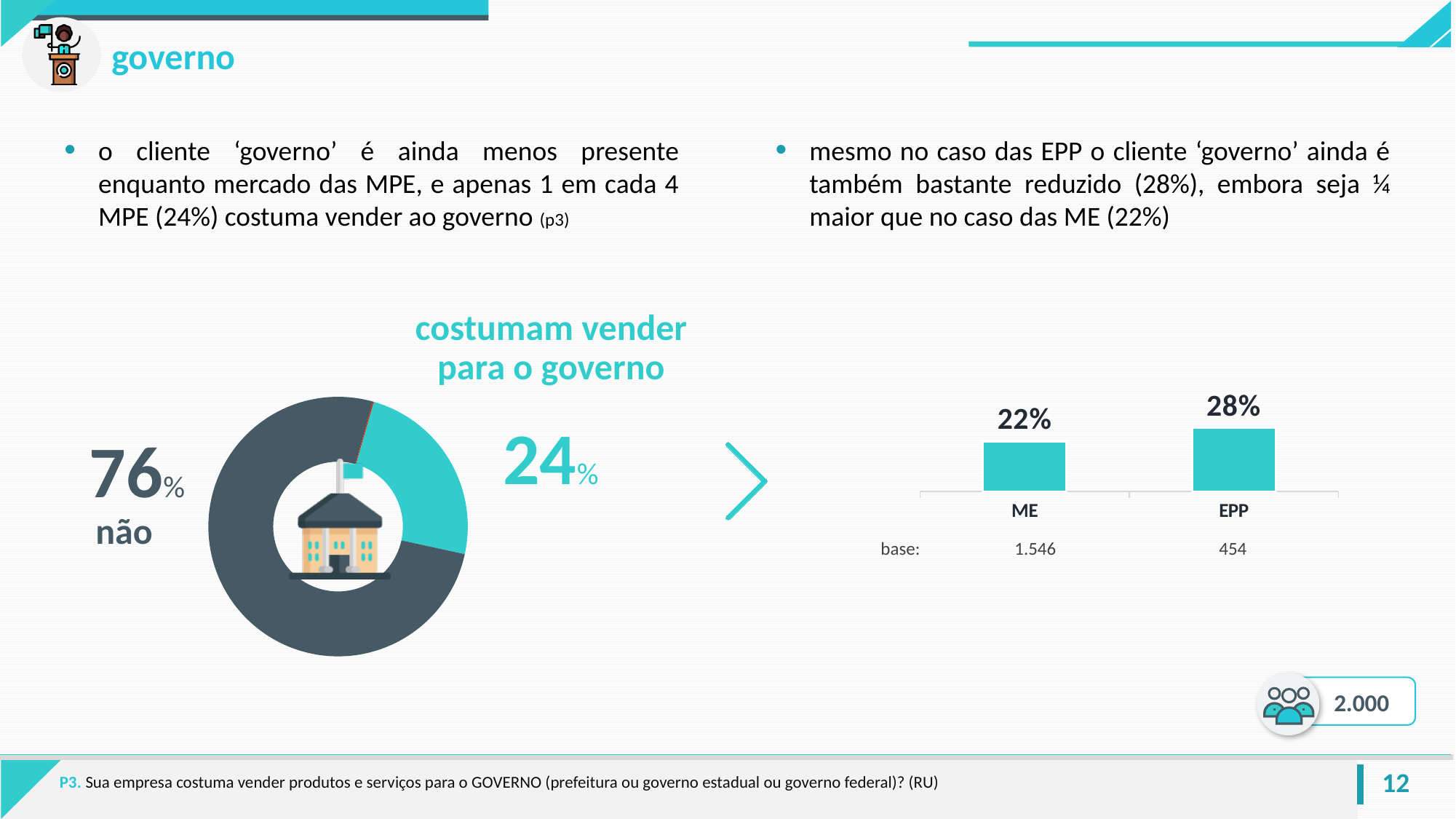
In the donut chart on the left, which slice is larger: 'não' or 'costumam vender para o governo'? não How many categories are shown in the bar chart on the right? 2 In the bar chart on the right, what is the value for EPP? 28% In the bar chart on the right, what is the base (sample size) shown for ME? 1.546 In the donut chart on the left, what is the difference between the 'não' share and the 'costumam vender para o governo' share? 52 percentage points In the donut chart on the left, what percentage is labelled 'não'? 76% In the bar chart on the right, which category has the lower value? ME In the bar chart on the right, which category has the higher value? EPP In the bar chart on the right, what is the difference between the EPP and ME values? 6 percentage points In the bar chart on the right, what is the value for ME? 22% What kind of chart is shown on the left of the slide? Donut (pie) chart In the donut chart on the left, what percentage of MPE costumam vender para o governo? 24%